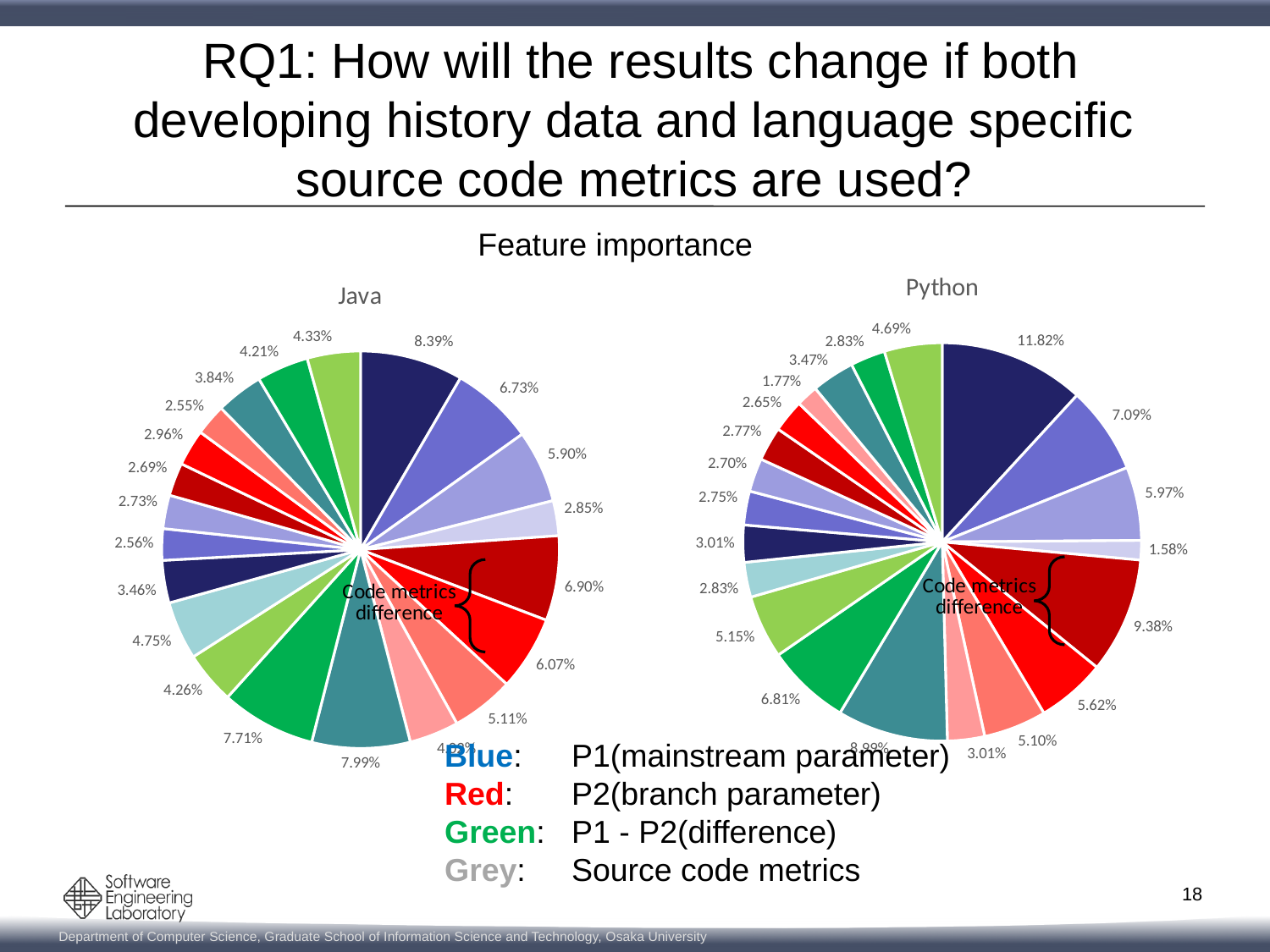
Which chart has the larger single largest slice, Java or Python? Python What kind of chart is used for the Java and Python feature importance charts? Pie chart According to the colour key, what do the grey slices represent? Source code metrics How many pie charts are shown on the slide? 2 In the Python pie chart, what is the percentage of the largest slice? 11.82% What is the difference between the largest slice in the Python pie chart and the largest slice in the Java pie chart? 3.43 percentage points In the Python pie chart, which two slice percentages are bracketed as "Code metrics difference"? 9.38% and 5.62% According to the colour key, what do the blue slices represent? P1(mainstream parameter) In the Java pie chart, what is the smallest percentage label shown? 2.55% In the Java pie chart, what is the percentage of the largest slice? 8.39% In the Java pie chart, which two slice percentages are bracketed as "Code metrics difference"? 6.90% and 6.07% In the Python pie chart, what is the percentage of the smallest slice? 1.58%